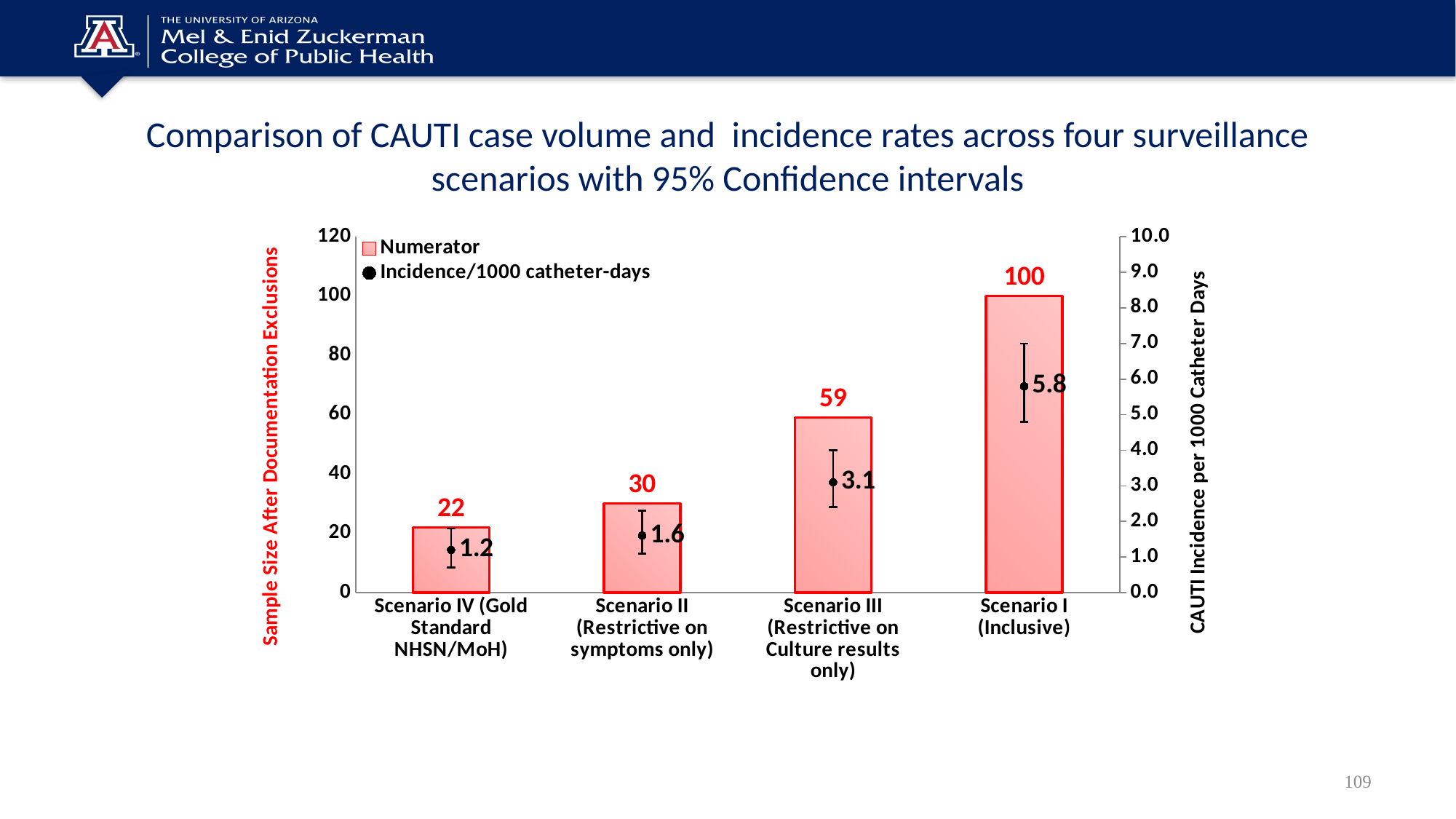
Which scenario has the lowest Incidence/1000 catheter-days value? Scenario IV (Gold Standard NHSN/MoH) Which has a larger Numerator value, Scenario II (Restrictive on symptoms only) or Scenario III (Restrictive on Culture results only)? Scenario III (Restrictive on Culture results only) What is the difference between the Numerator values for Scenario I (Inclusive) and Scenario III (Restrictive on Culture results only)? 41 What is the Incidence/1000 catheter-days value for Scenario II (Restrictive on symptoms only)? 1.6 Do the Numerator values rise or fall from left to right along the x axis? rise What is the Incidence/1000 catheter-days value for Scenario III (Restrictive on Culture results only)? 3.1 Which scenario has the highest Numerator value? Scenario I (Inclusive) How many series does the chart legend list? 2 How many scenarios are shown on the x axis of the chart? 4 What is the difference between the Incidence/1000 catheter-days values for Scenario I (Inclusive) and Scenario IV (Gold Standard NHSN/MoH)? 4.6 What is the Numerator value for Scenario I (Inclusive)? 100 What is the Numerator value for Scenario IV (Gold Standard NHSN/MoH)? 22